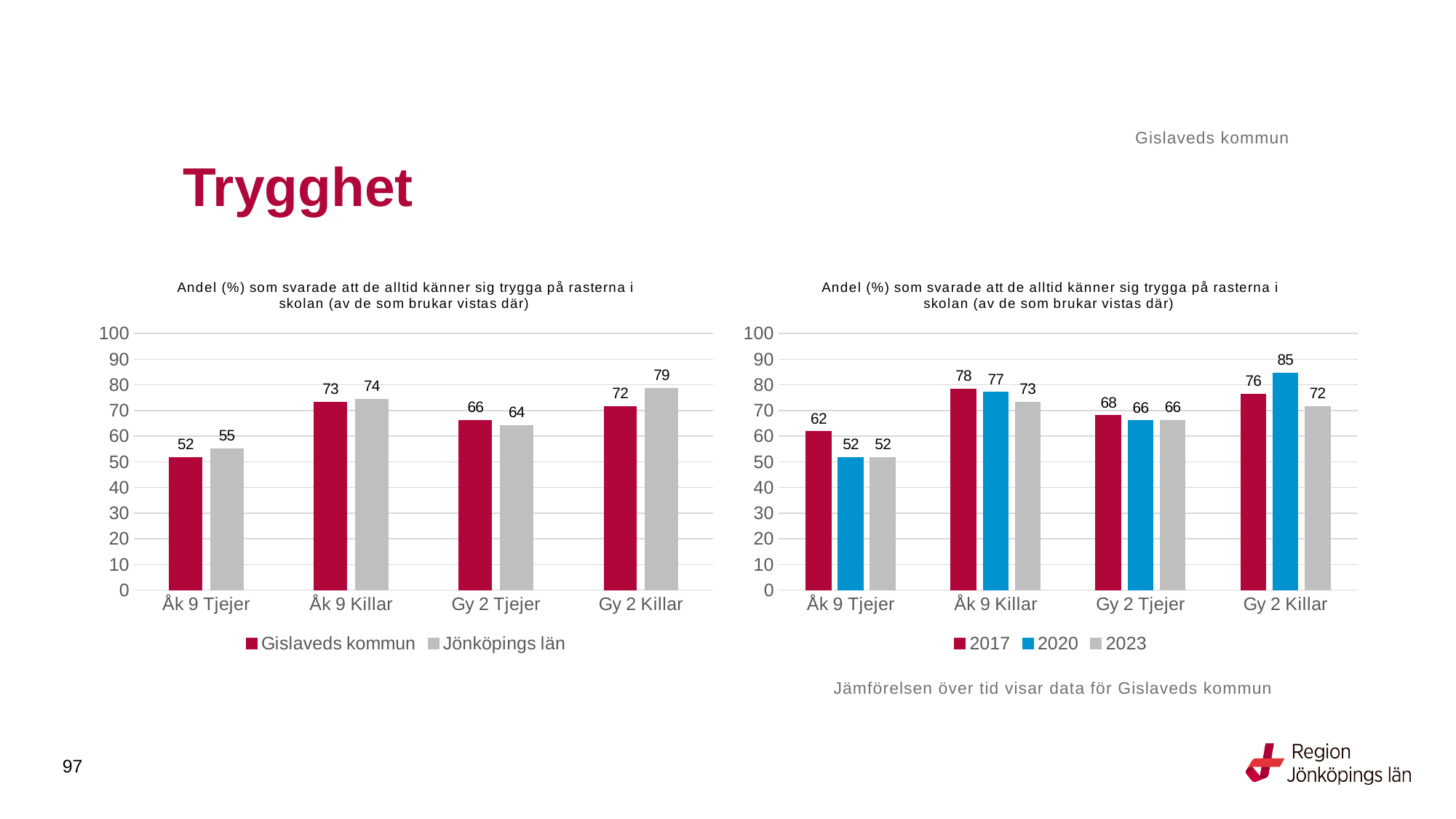
In the right chart, what is the value for 2023 for Åk 9 Killar? 73 In the right chart, what is the difference between the 2017 and 2023 values for Åk 9 Tjejer? 10 In the right chart, what is the value for 2020 for Gy 2 Killar? 85 In the left chart, how many series does the legend list? 2 In the left chart, what is the difference between Jönköpings län and Gislaveds kommun for Gy 2 Killar? 7 In the left chart, which is larger for Gy 2 Tjejer: Gislaveds kommun or Jönköpings län? Gislaveds kommun What kind of chart is the right chart? Bar chart In the right chart, how many categories are shown on the x axis? 4 In the left chart, what is the value for Jönköpings län for Gy 2 Killar? 79 In the right chart, which category has the highest value for 2017? Åk 9 Killar In the left chart, which category has the lowest value for Gislaveds kommun? Åk 9 Tjejer In the left chart, what is the value for Gislaveds kommun for Åk 9 Tjejer? 52